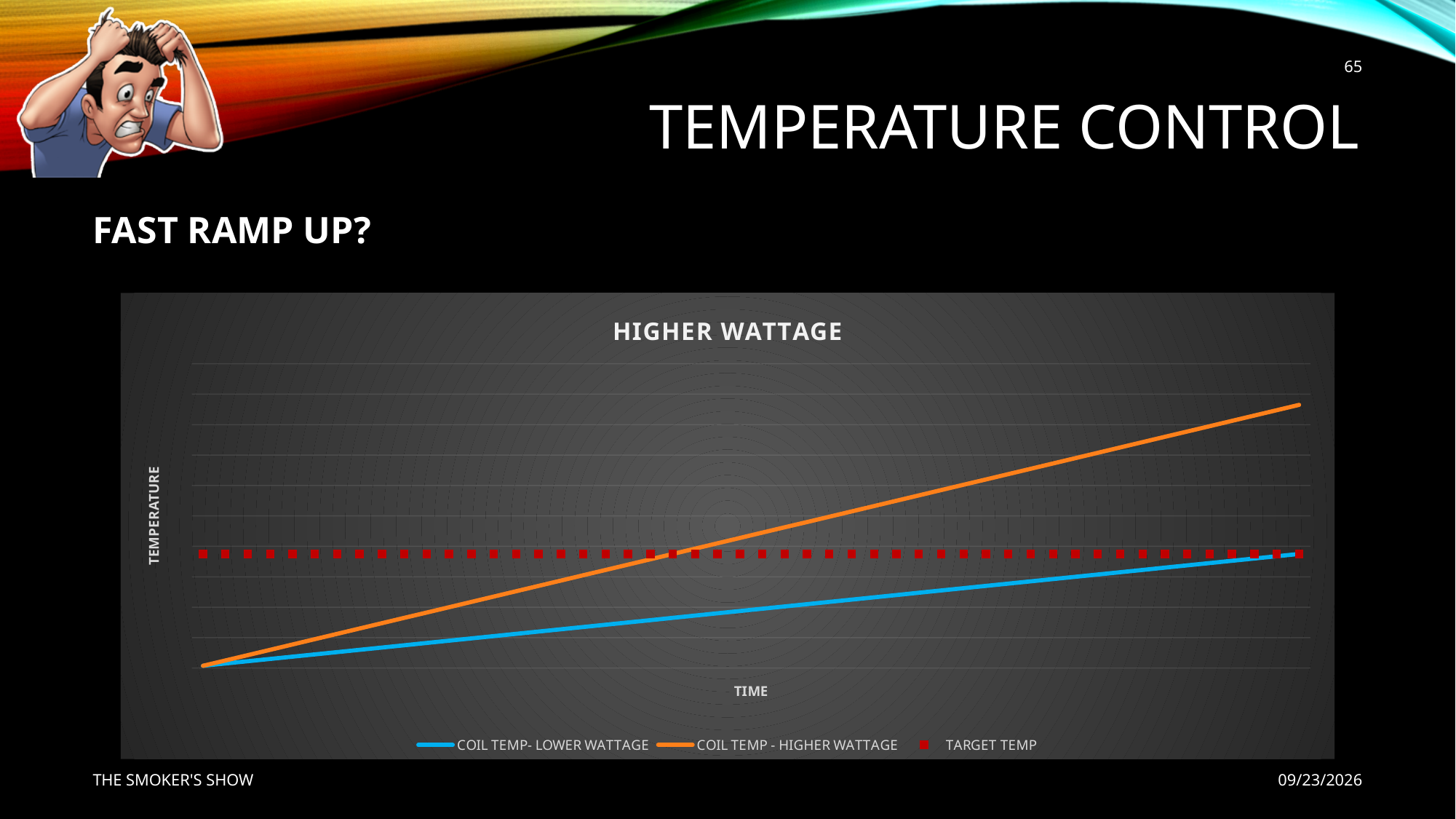
At the right end of the chart, which series is higher: COIL TEMP - HIGHER WATTAGE or COIL TEMP- LOWER WATTAGE? COIL TEMP - HIGHER WATTAGE What is the label on the vertical axis of the chart? TEMPERATURE At the right end of the chart, which is higher: COIL TEMP - HIGHER WATTAGE or TARGET TEMP? COIL TEMP - HIGHER WATTAGE Which series reaches the highest temperature on the chart? COIL TEMP - HIGHER WATTAGE Which series rises more steeply over time: COIL TEMP- LOWER WATTAGE or COIL TEMP - HIGHER WATTAGE? COIL TEMP - HIGHER WATTAGE What kind of chart is shown on the slide? Line chart Does the COIL TEMP- LOWER WATTAGE line rise or fall along the time axis? Rise Does the TARGET TEMP series rise, fall, or stay flat along the time axis? Stay flat How many series does the chart's legend list? 3 What is the title of the chart? HIGHER WATTAGE Does the COIL TEMP - HIGHER WATTAGE line rise or fall along the time axis? Rise